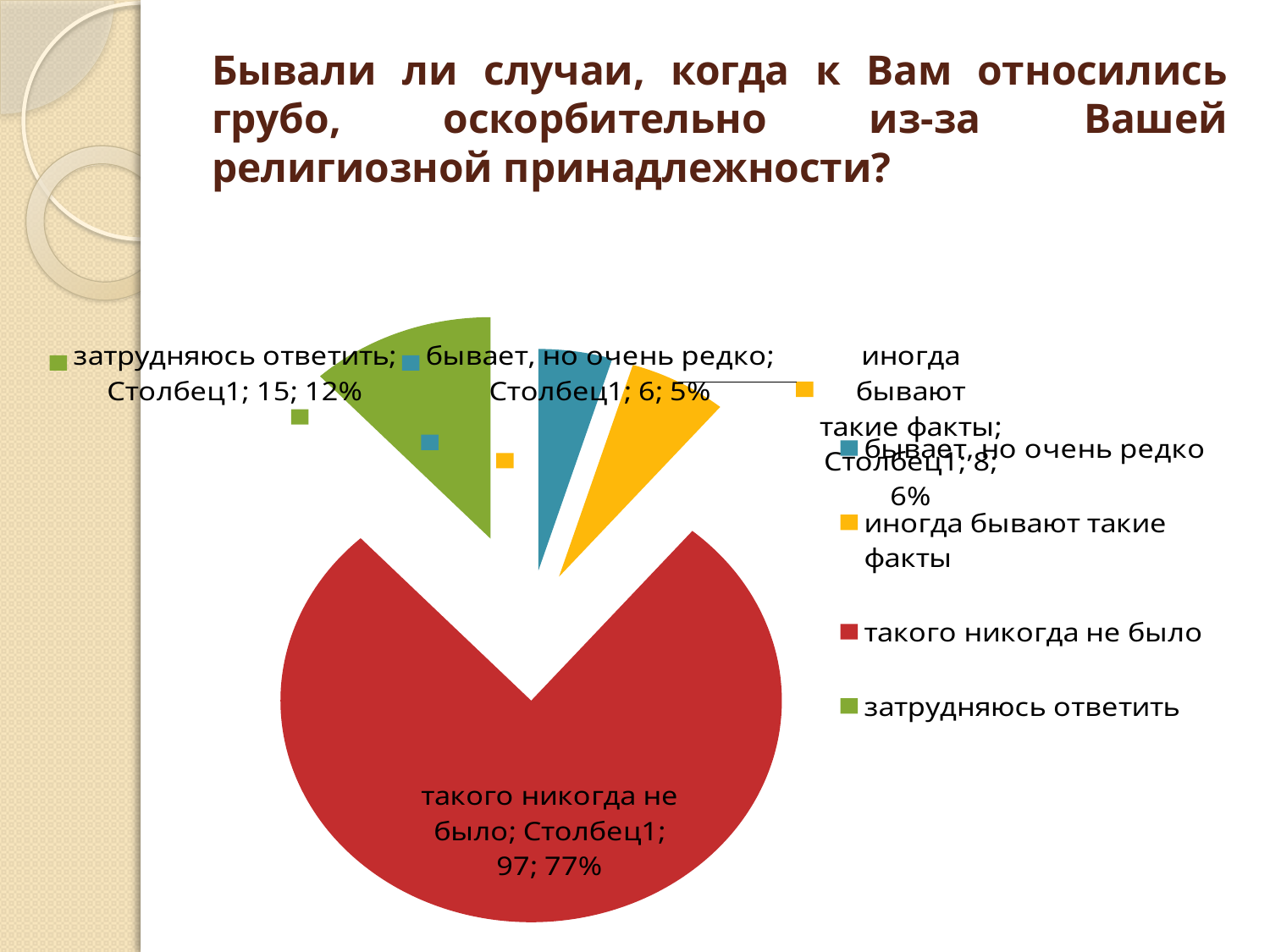
What percentage share does the slice "иногда бывают такие факты" have? 6% Which slice is the largest? такого никогда не было What value is shown for the slice "бывает, но очень редко"? 6 What kind of chart is shown on the slide? pie chart Which slice is the smallest? бывает, но очень редко What is the difference between the values for "такого никогда не было" and "затрудняюсь ответить"? 82 What value is shown for the slice "такого никогда не было"? 97 What percentage share does the slice "затрудняюсь ответить" have? 12% What percentage share does the slice "такого никогда не было" have? 77% How many slices does the pie chart have? 4 What value is shown for the slice "затрудняюсь ответить"? 15 How many entries does the legend list? 4